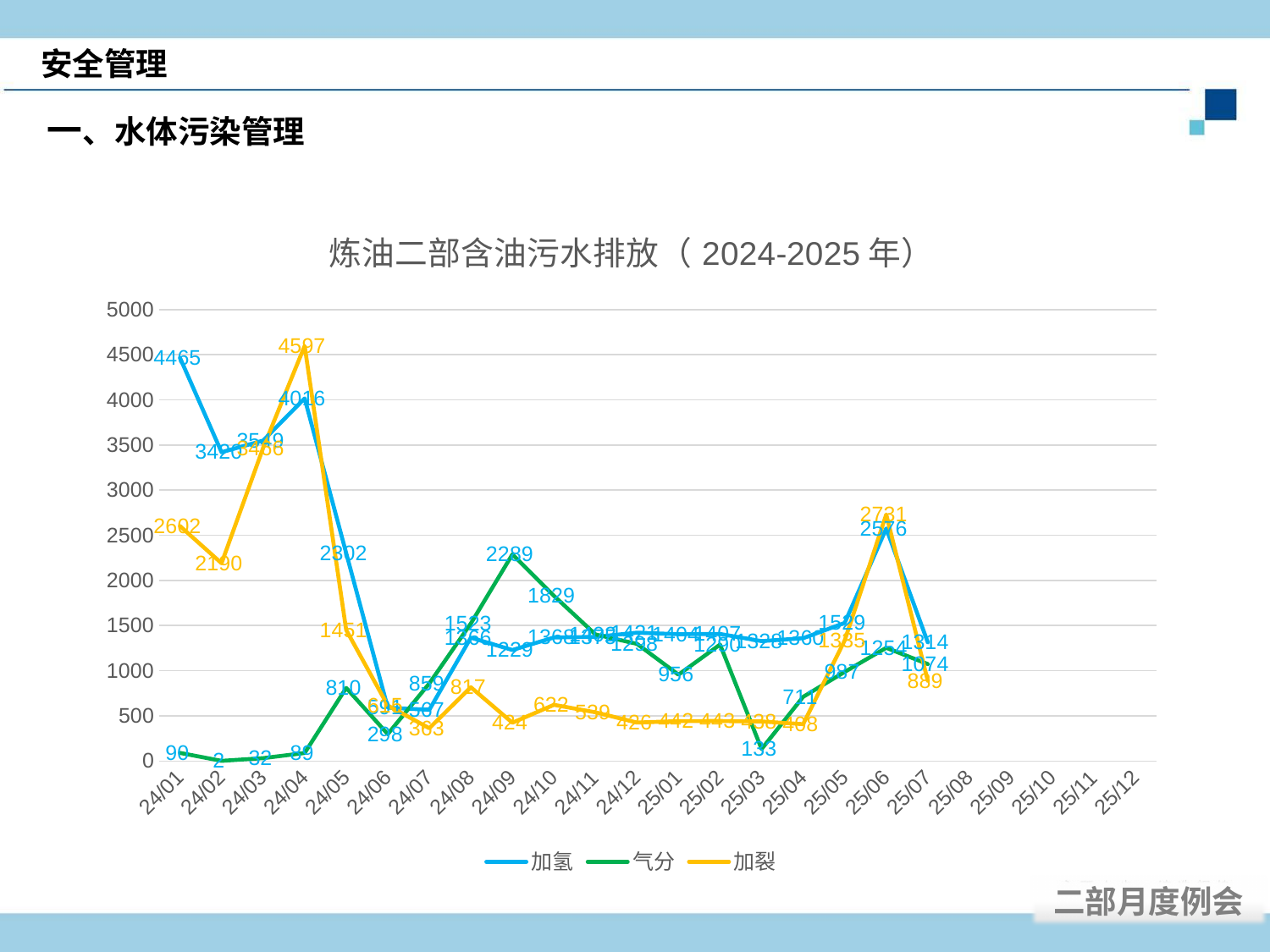
In 24/01, which is larger, 加氢 or 加裂? 加氢 What is the value for 气分 in 25/03? 133 What is the value for 气分 in 24/09? 2289 What is the difference between the 加裂 values in 24/01 and 24/02? 412 In which month is the 气分 value lowest? 24/02 In which month does 加裂 reach its highest value? 24/04 What is the value for 加氢 in 24/01? 4465 What are the three series named in the legend? 加氢, 气分, 加裂 What is the difference between 加裂 and 加氢 in 25/06? 155 How many series does the legend list? 3 What kind of chart is shown on the slide? line chart What is the value for 加裂 in 24/04? 4597